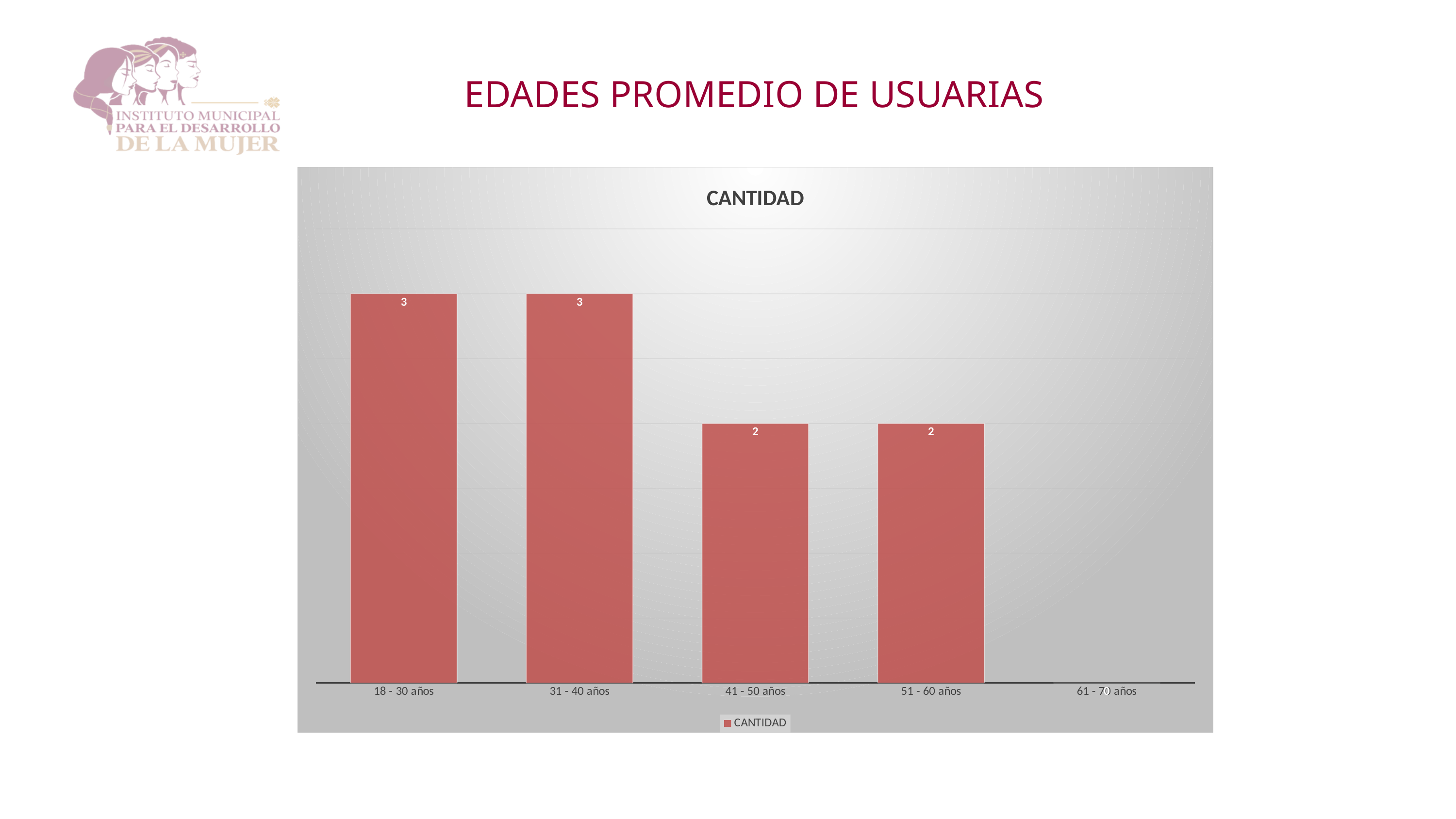
How many series does the legend list? 1 What kind of chart is shown on the slide? bar chart Which age group has the lowest value? 61 - 70 años What is the value for 51 - 60 años? 2 What is the title of the chart? CANTIDAD Do the values rise or fall from left to right along the x axis? fall What is the value for 41 - 50 años? 2 What is the difference between the values for 31 - 40 años and 51 - 60 años? 1 How many age groups are shown on the x axis? 5 What is the value for 61 - 70 años? 0 What is the value for 18 - 30 años? 3 Which is larger, the value for 18 - 30 años or the value for 41 - 50 años? 18 - 30 años